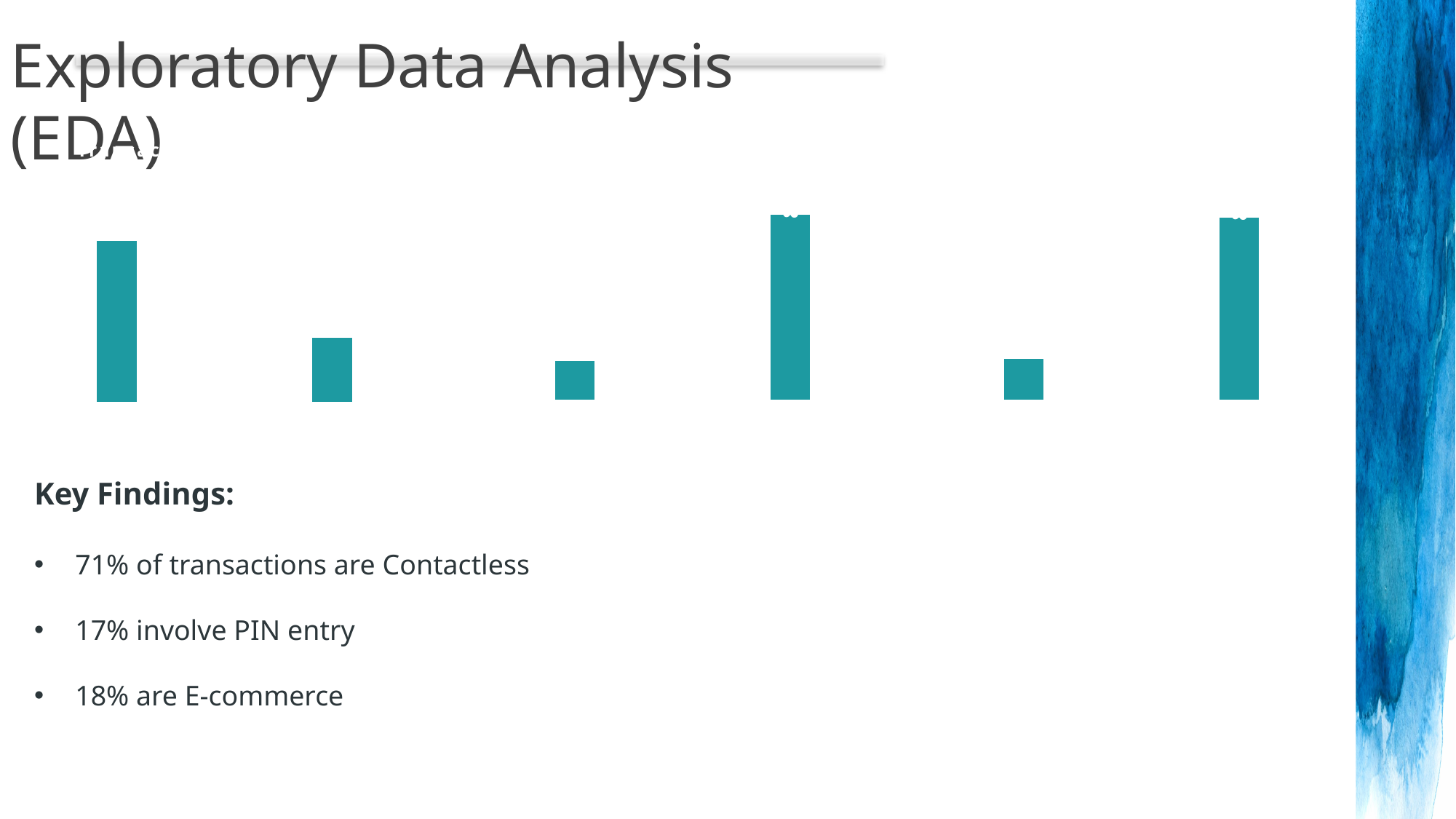
Which is taller in the chart: the first bar from the left or the second bar from the left? the first bar What colour are the bars in the chart? teal Which is taller in the chart: the first bar from the left or the fourth bar from the left? the fourth bar Are the bars in the chart vertical or horizontal? vertical Which is taller in the chart: the fourth bar from the left or the fifth bar from the left? the fourth bar What kind of chart is shown on the slide? bar chart How many bars does the chart on the slide contain? 6